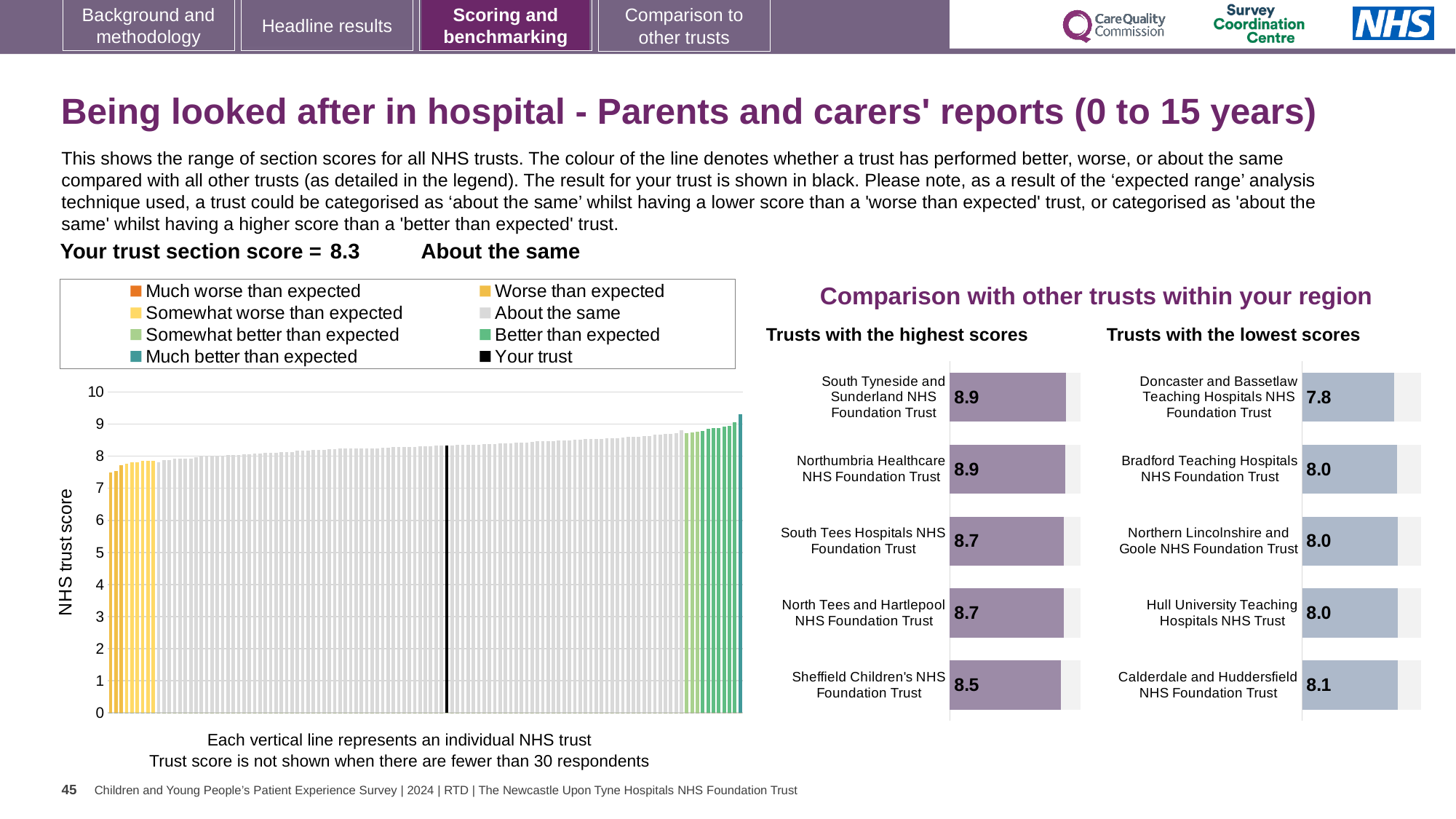
In the 'Trusts with the lowest scores' chart, what is the difference between the score for Calderdale and Huddersfield NHS Foundation Trust and the score for Doncaster and Bassetlaw Teaching Hospitals NHS Foundation Trust? 0.3 Which is larger: the score for Northumbria Healthcare NHS Foundation Trust in the 'Trusts with the highest scores' chart, or the score for Bradford Teaching Hospitals NHS Foundation Trust in the 'Trusts with the lowest scores' chart? Northumbria Healthcare NHS Foundation Trust In the 'Trusts with the highest scores' chart, what is the score for South Tees Hospitals NHS Foundation Trust? 8.7 In the main 'NHS trust score' chart on the left, do the bar values rise or fall from left to right? rise In the 'Trusts with the lowest scores' chart, what is the score for Doncaster and Bassetlaw Teaching Hospitals NHS Foundation Trust? 7.8 In the 'Trusts with the highest scores' chart, what is the difference between the score for South Tyneside and Sunderland NHS Foundation Trust and the score for Sheffield Children's NHS Foundation Trust? 0.4 In the 'Trusts with the highest scores' chart, what is the score for Sheffield Children's NHS Foundation Trust? 8.5 How many entries does the legend of the main 'NHS trust score' chart on the left list? 8 In the 'Trusts with the lowest scores' chart, which trust has the lowest score? Doncaster and Bassetlaw Teaching Hospitals NHS Foundation Trust How many trusts are shown in the 'Trusts with the highest scores' chart? 5 In the 'Trusts with the lowest scores' chart, which trust has the highest score? Calderdale and Huddersfield NHS Foundation Trust In the main 'NHS trust score' chart on the left, is the value of the lowest (leftmost) bar greater or less than 8? less